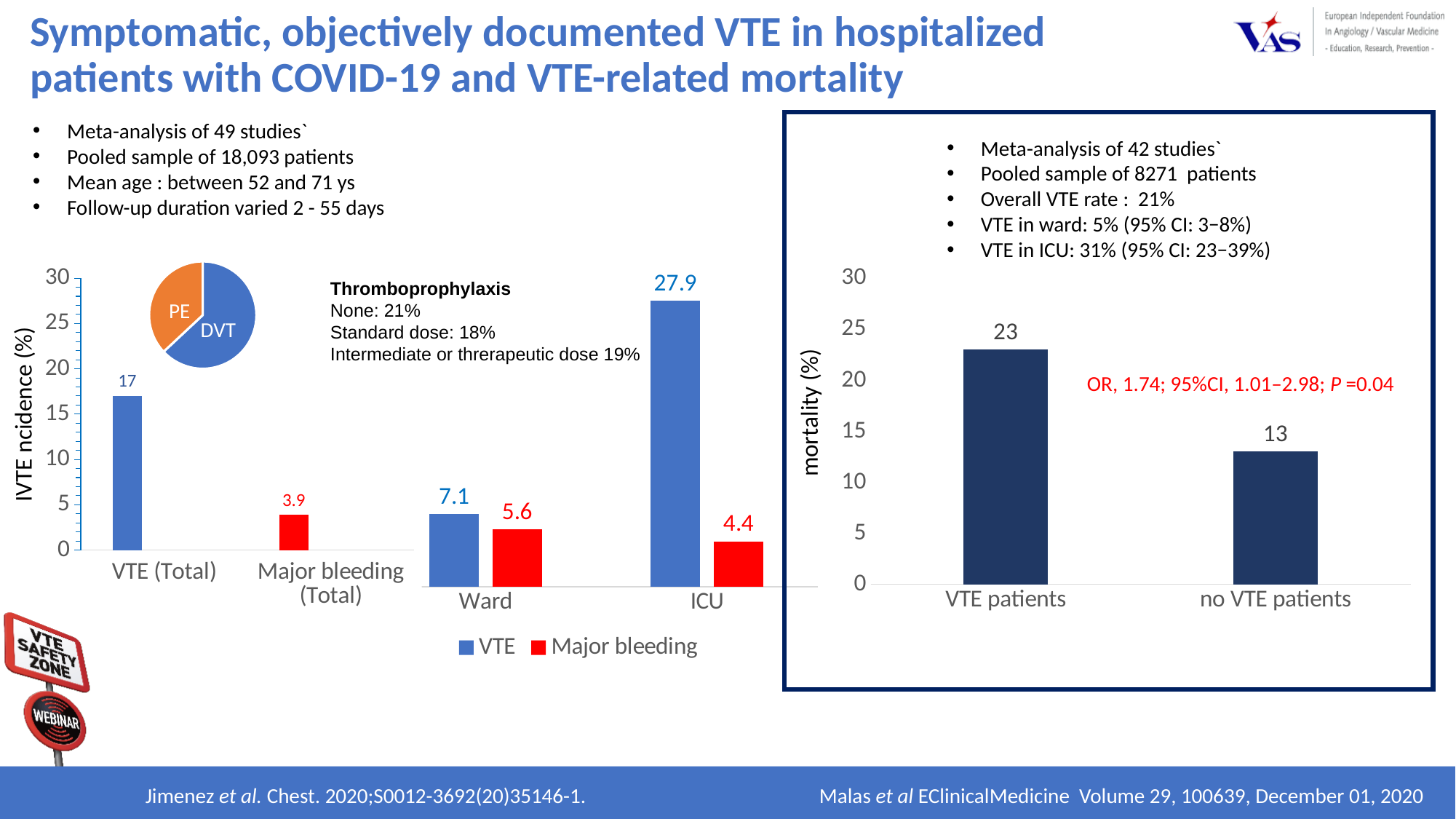
In the Ward/ICU grouped bar chart in the middle, is the Major bleeding value larger for Ward or for ICU? Ward In the mortality bar chart on the right, what is the mortality (%) for no VTE patients? 13 In the Ward/ICU grouped bar chart in the middle, what is the difference between the VTE values for ICU and Ward? 20.8 In the Ward/ICU grouped bar chart in the middle, how many series does the legend list? 2 In the mortality bar chart on the right, what is the mortality (%) for VTE patients? 23 In the leftmost bar chart, what is the value for Major bleeding (Total)? 3.9 In the Ward/ICU grouped bar chart in the middle, what is the VTE value for ICU? 27.9 In the mortality bar chart on the right, what is the difference in mortality (%) between VTE patients and no VTE patients? 10 In the mortality bar chart on the right, which category has the higher mortality? VTE patients In the leftmost bar chart, what is the value for VTE (Total)? 17 What kind of chart is the small chart labelled PE and DVT? Pie chart In the Ward/ICU grouped bar chart in the middle, what is the Major bleeding value for Ward? 5.6